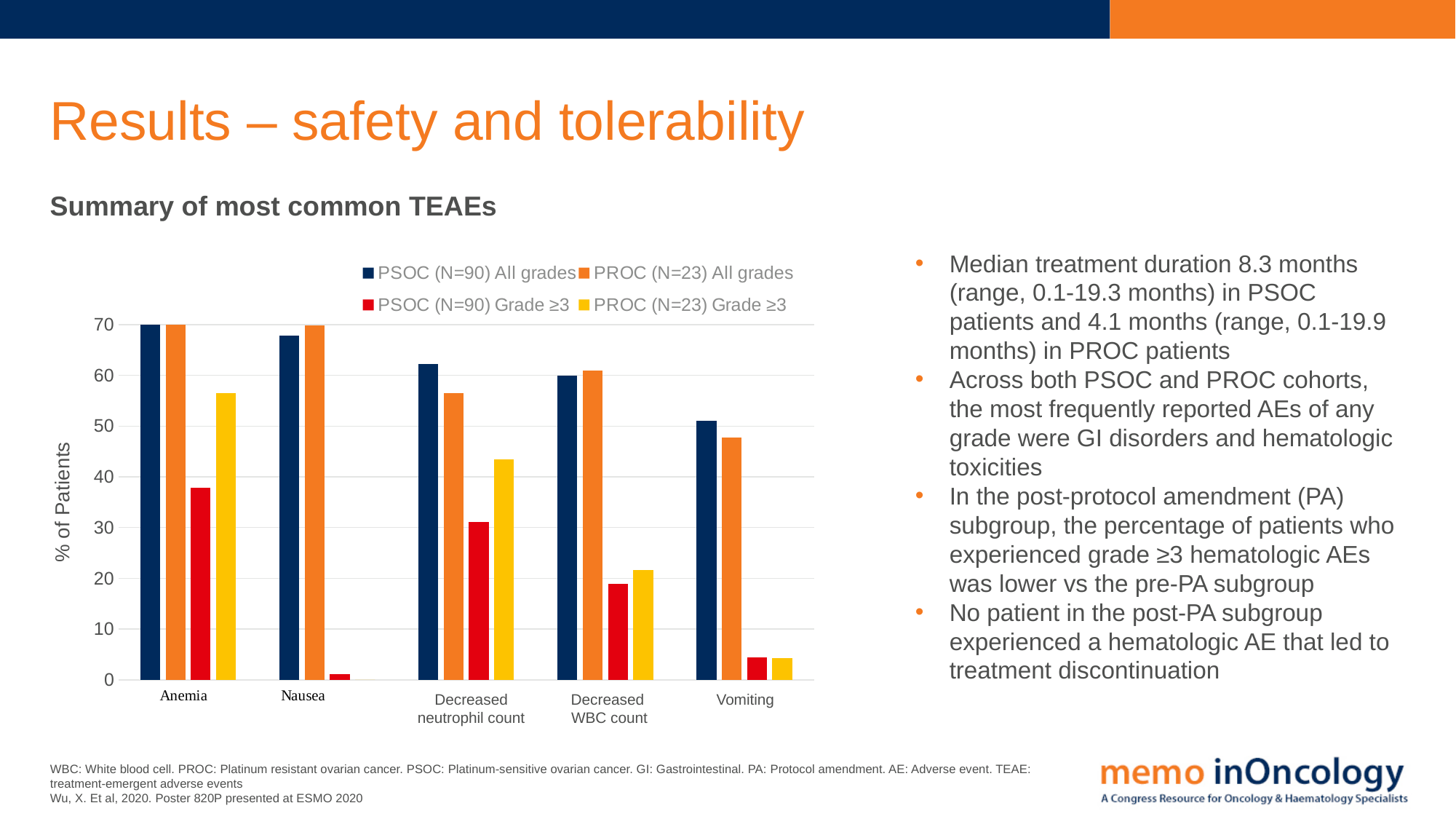
What kind of chart is shown on the slide? bar chart Is the value for PROC (N=23) All grades for Vomiting greater or less than 50? less For Anemia, which is larger: PSOC (N=90) Grade ≥3 or PROC (N=23) Grade ≥3? PROC (N=23) Grade ≥3 Which category has the lowest value for PSOC (N=90) Grade ≥3? Nausea How many adverse event categories are shown on the x axis of the chart? 5 Is the value for PROC (N=23) Grade ≥3 for Anemia greater or less than 50? greater Which category has the highest value for PROC (N=23) Grade ≥3? Anemia Do the values for PSOC (N=90) All grades rise or fall from Anemia to Vomiting along the x axis? fall How many series does the chart legend list? 4 What is the label of the y axis of the chart? % of Patients Is the value for PSOC (N=90) Grade ≥3 for Anemia greater or less than 40? less